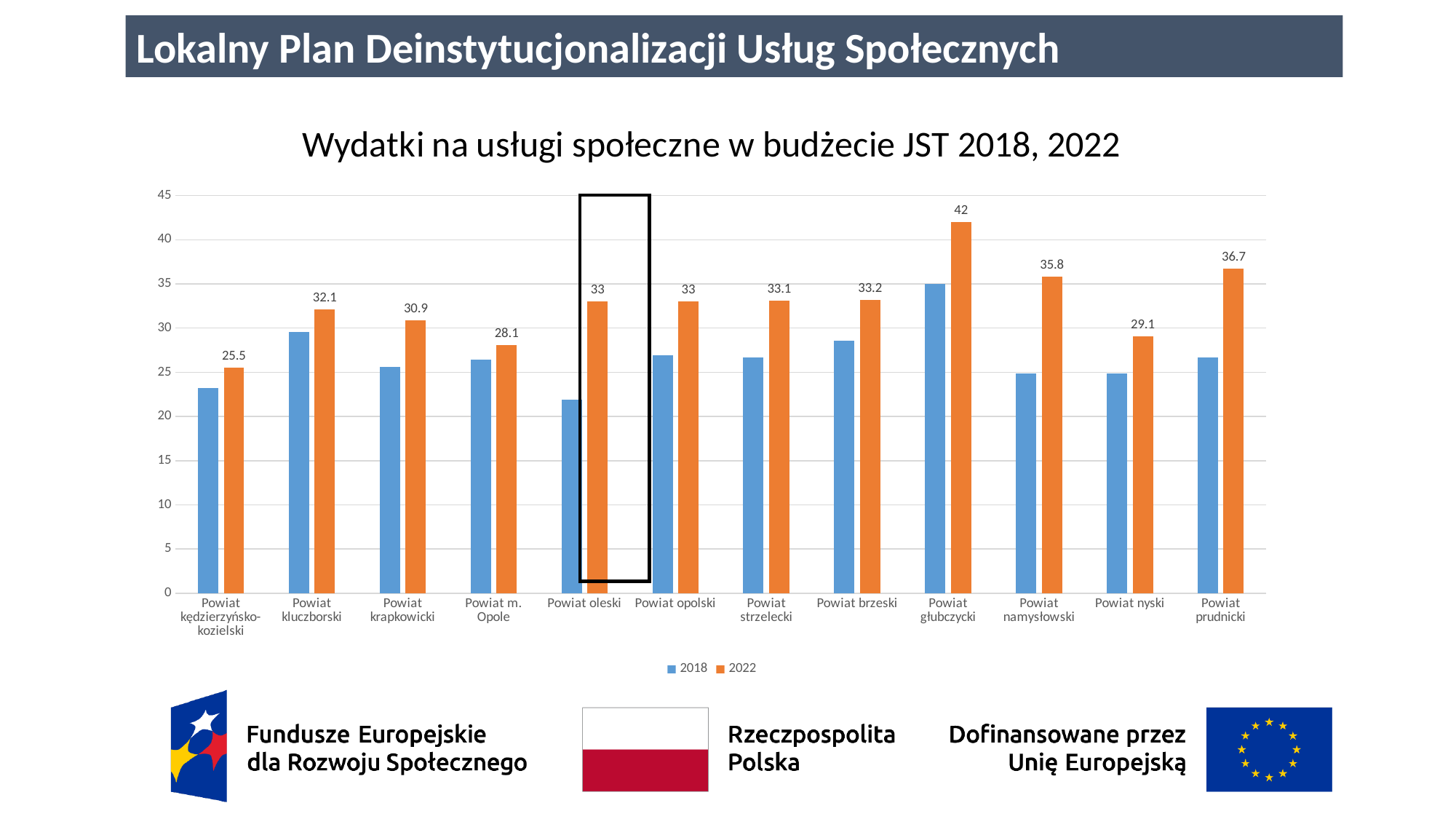
Which has the larger 2022 value, Powiat prudnicki or Powiat namysłowski? Powiat prudnicki What is the difference between the 2022 values for Powiat głubczycki and Powiat kędzierzyńsko-kozielski? 16.5 What kind of chart is shown on the slide? bar chart How many series does the legend list? 2 What is the 2022 value for Powiat głubczycki? 42 Which category has the lowest 2022 value? Powiat kędzierzyńsko-kozielski Which category has the highest 2022 value? Powiat głubczycki What is the 2022 value for Powiat kędzierzyńsko-kozielski? 25.5 What is the 2022 value for Powiat m. Opole? 28.1 Is the 2018 value for Powiat oleski greater or less than 25? less What is the 2022 value for Powiat namysłowski? 35.8 How many categories (powiats) are shown on the x axis? 12